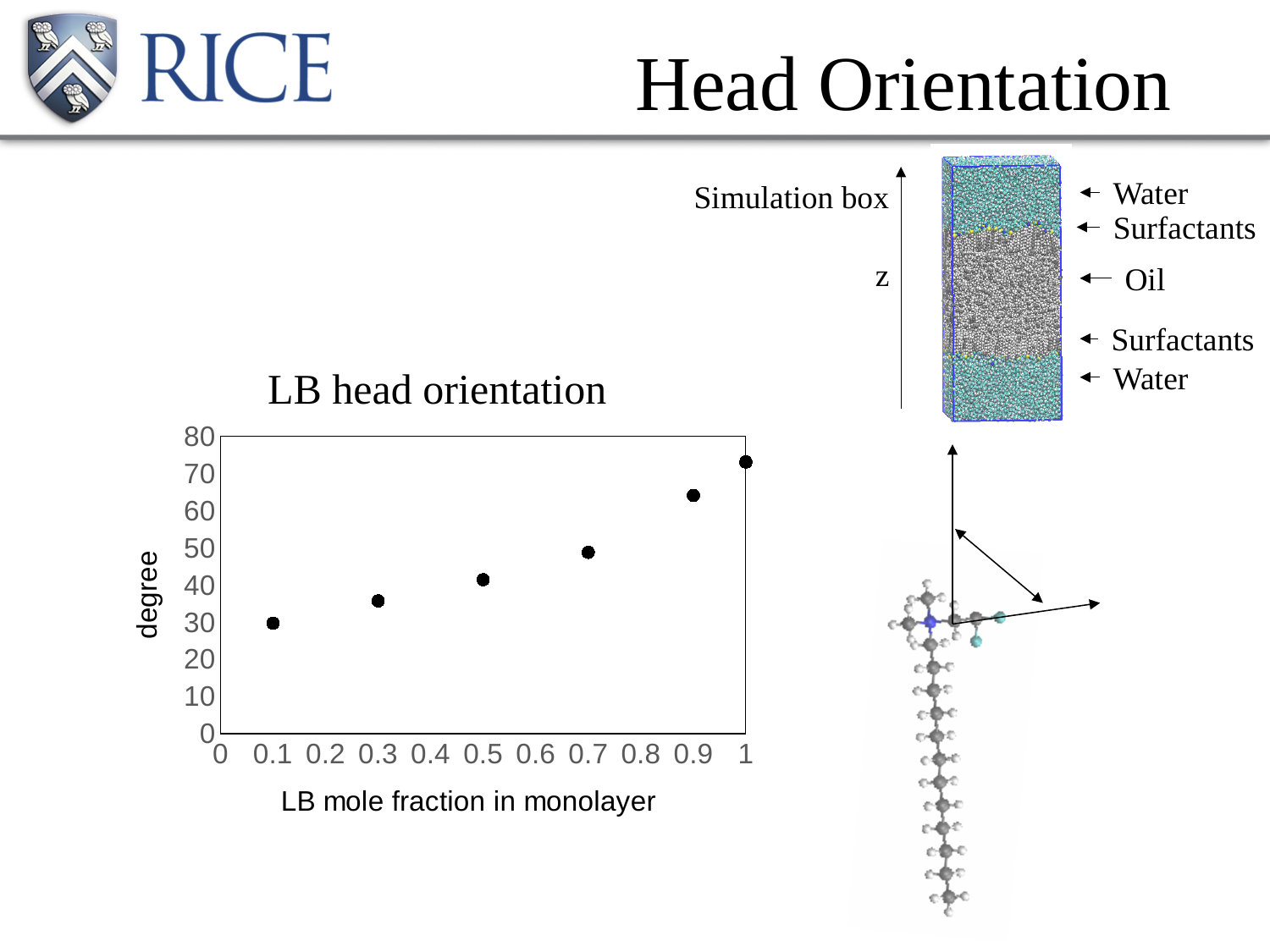
In the 'LB head orientation' chart, is the value at LB mole fraction 0.1 greater or less than 40? less In the 'LB head orientation' chart, is the value at LB mole fraction 0.9 greater or less than 60? greater What is the y-axis label of the 'LB head orientation' chart? degree In the 'LB head orientation' chart, which has the larger value: LB mole fraction 0.9 or 0.5? 0.9 What is the x-axis label of the 'LB head orientation' chart? LB mole fraction in monolayer In the 'LB head orientation' chart, at which LB mole fraction is the head orientation highest? 1 In the 'LB head orientation' chart, is the value at LB mole fraction 1 greater or less than 70? greater How many data points are plotted in the 'LB head orientation' chart? 6 In the 'LB head orientation' chart, do the values rise or fall as the LB mole fraction increases? rise What kind of chart is the 'LB head orientation' chart? scatter chart In the 'LB head orientation' chart, at which LB mole fraction is the head orientation lowest? 0.1